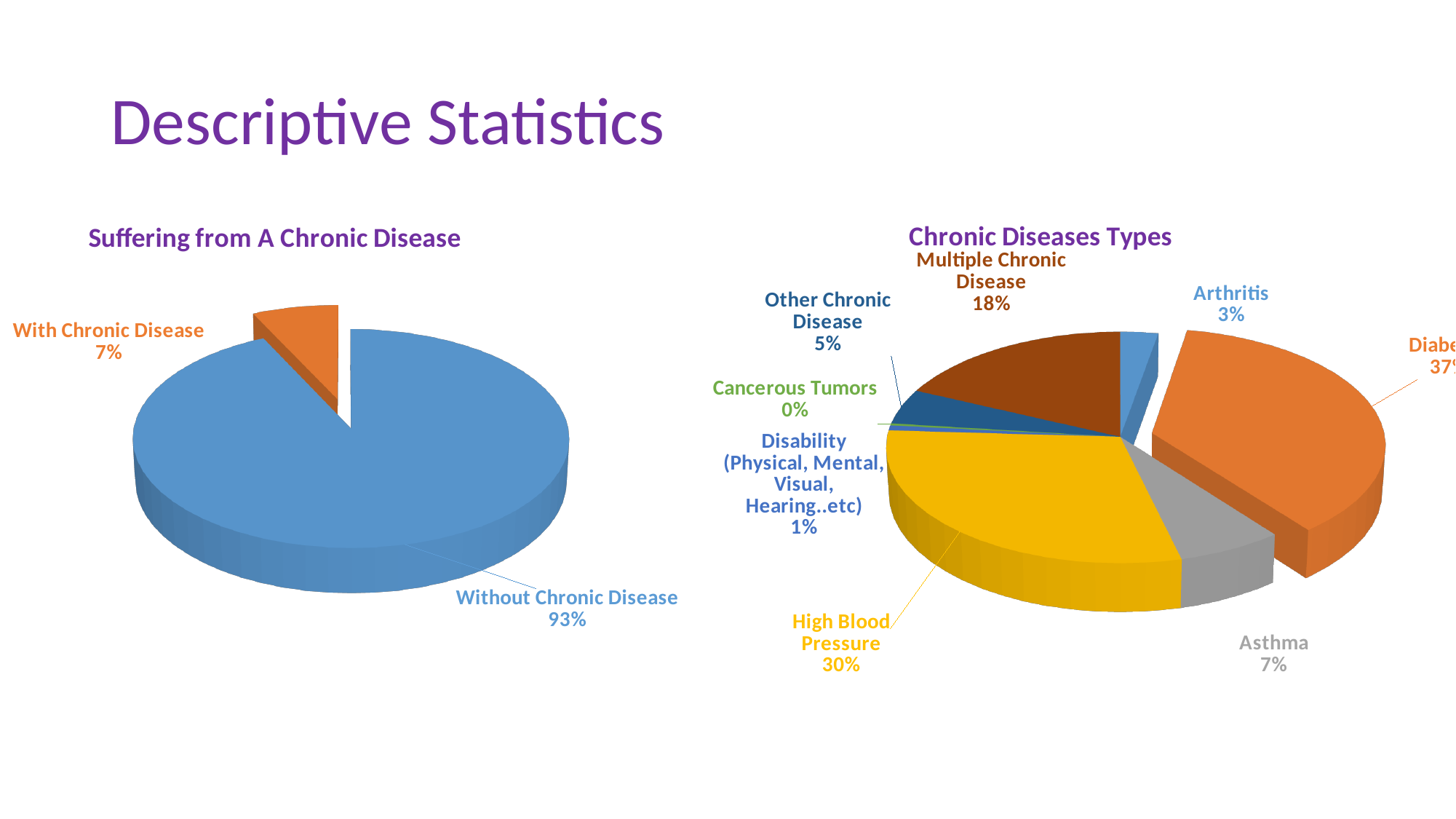
In the 'Chronic Diseases Types' chart, what is the difference between 'High Blood Pressure' and 'Multiple Chronic Disease'? 12% In the 'Chronic Diseases Types' chart, what percentage is labelled 'Asthma'? 7% In the 'Chronic Diseases Types' chart, what percentage is labelled 'Multiple Chronic Disease'? 18% In the 'Suffering from A Chronic Disease' chart, what percentage is labelled 'Without Chronic Disease'? 93% In the 'Chronic Diseases Types' chart, what percentage is labelled 'Cancerous Tumors'? 0% What kind of chart is the 'Suffering from A Chronic Disease' chart? Pie chart In the 'Chronic Diseases Types' chart, which is larger: 'Other Chronic Disease' or 'Arthritis'? Other Chronic Disease In the 'Suffering from A Chronic Disease' chart, which category has the larger share? Without Chronic Disease How many slices does the 'Chronic Diseases Types' pie chart have? 8 In the 'Suffering from A Chronic Disease' chart, what is the difference between the 'Without Chronic Disease' and 'With Chronic Disease' shares? 86% In the 'Chronic Diseases Types' chart, what percentage is labelled 'High Blood Pressure'? 30% In the 'Suffering from A Chronic Disease' chart, what percentage is labelled 'With Chronic Disease'? 7%